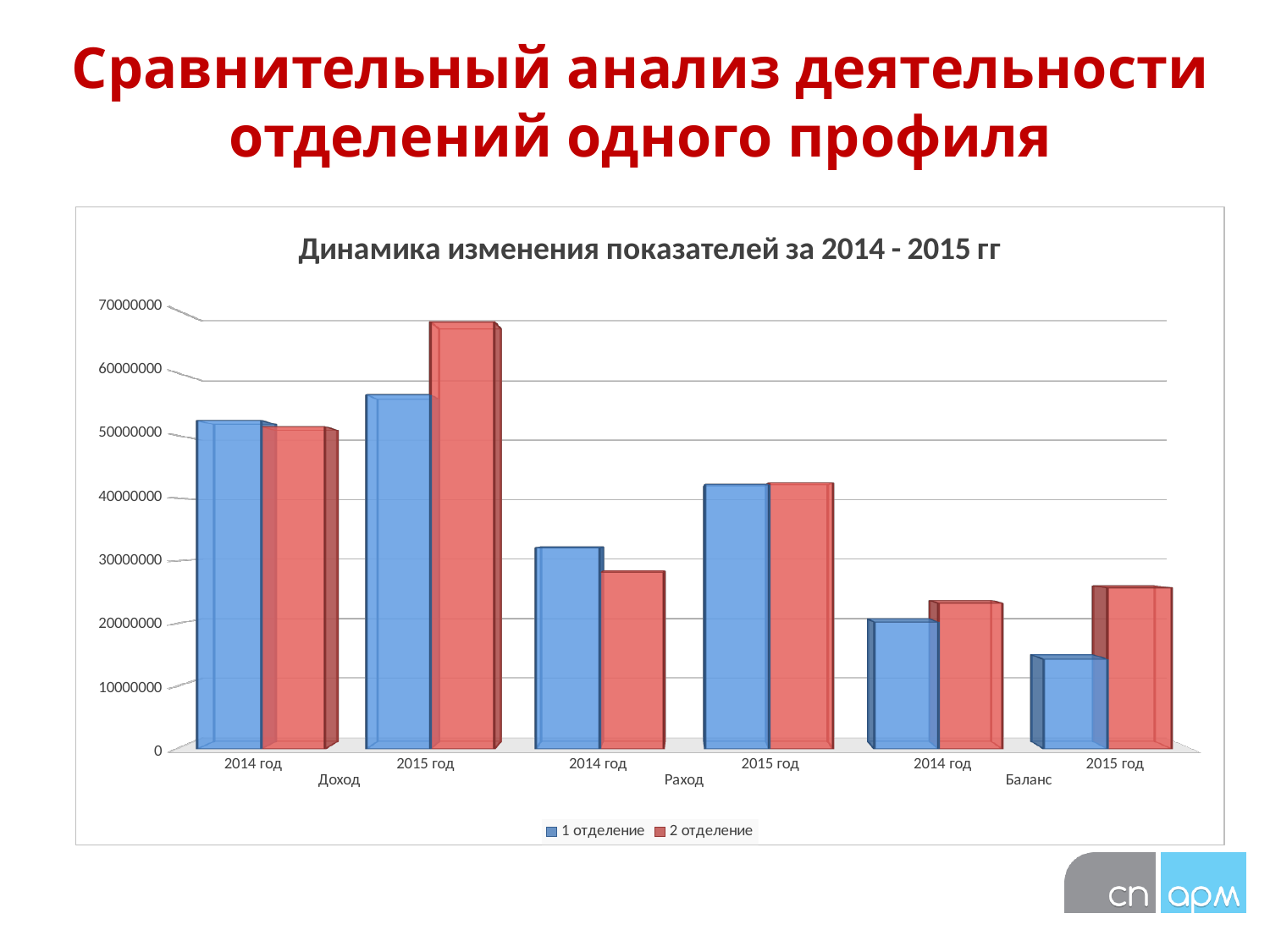
Which bar is the highest in the chart? 2 отделение, Доход 2015 год What type of chart is shown on the slide? Bar chart For Доход 2015 год, which series has the larger value, 1 отделение or 2 отделение? 2 отделение What is the title of the chart? Динамика изменения показателей за 2014 - 2015 гг Is the value for 1 отделение in Баланс 2015 год greater or less than 20000000? less Which bar is the lowest in the chart? 1 отделение, Баланс 2015 год How many series does the legend list? 2 For 1 отделение, does the Баланс value rise or fall from 2014 год to 2015 год? Fall Is the value for 2 отделение in Доход 2015 год greater or less than 60000000? greater Is the value for 2 отделение in Раход 2014 год greater or less than 30000000? less Which series is shown in red? 2 отделение How many category groups (year bars pairs) are plotted along the x axis? 6